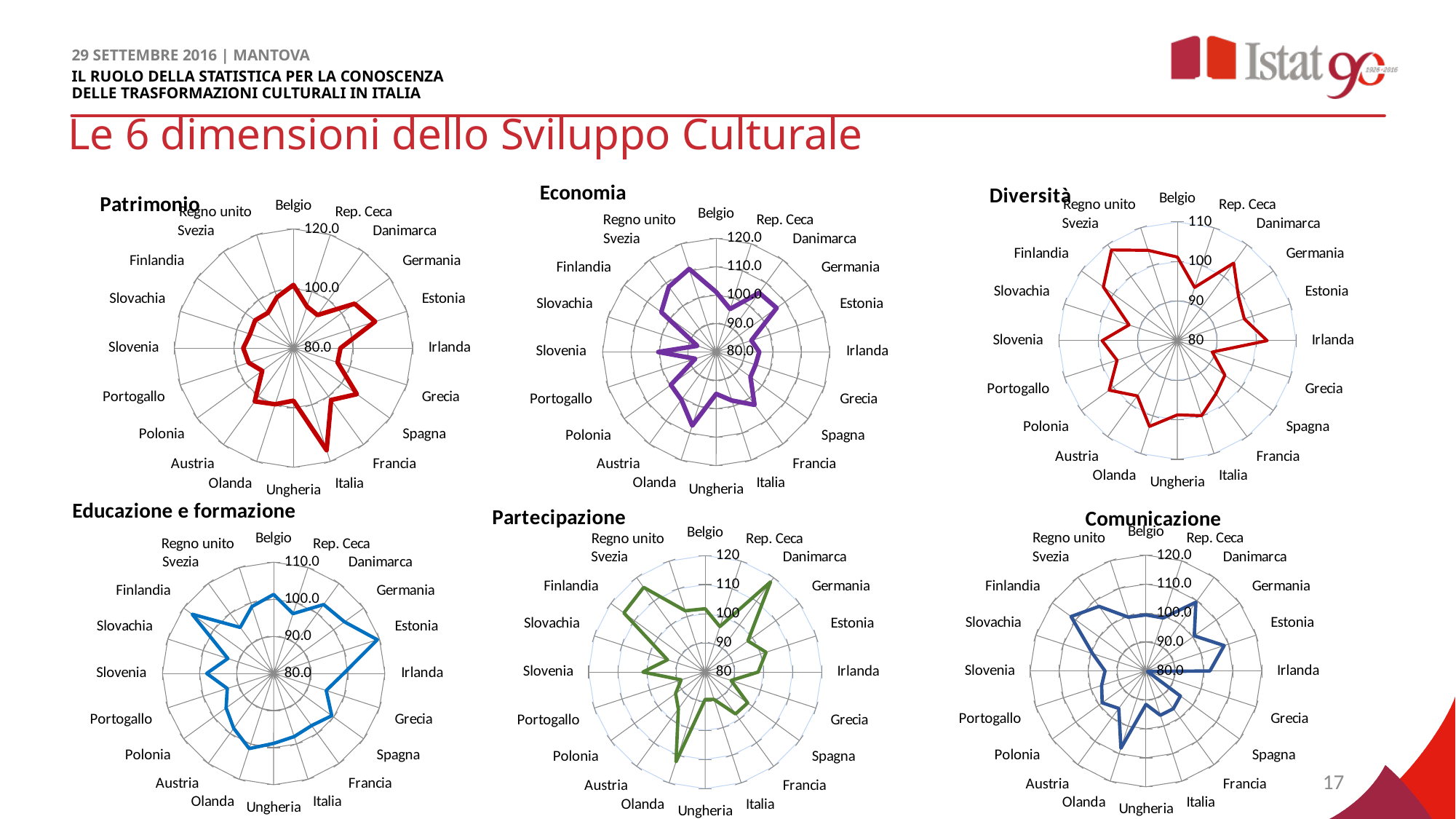
On the Patrimonio chart, which is larger, the value for Italia or the value for Belgio? Italia On the Patrimonio chart, is the value for Italia greater or less than 100? greater What kind of chart is the Patrimonio chart? radar chart How many radar charts are shown on the slide? 6 On the Educazione e formazione chart, is the value for Slovachia greater or less than 100? less How many countries are plotted on the Economia chart? 20 On the Patrimonio chart, which country has the highest value? Italia On the Diversità chart, is the value for Irlanda greater or less than 100? greater What colour is the line on the Partecipazione chart? green